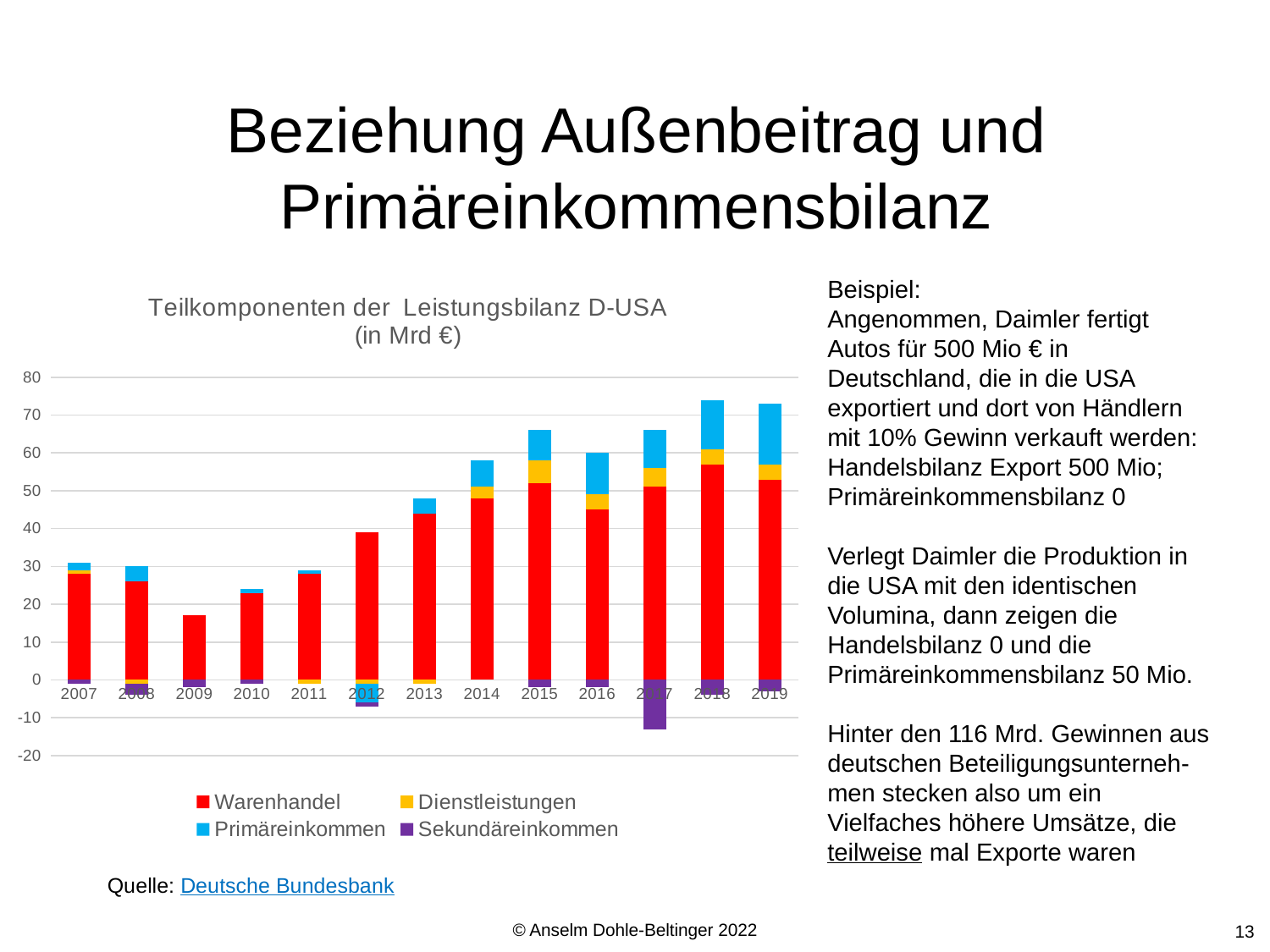
In which year is the Sekundäreinkommen (purple) segment the most negative? 2017 What is the title of the chart? Teilkomponenten der Leistungsbilanz D-USA (in Mrd €) Does the Warenhandel value generally rise or fall from 2009 to 2018? rise How many years are shown on the x axis? 13 How many series does the legend list? 4 In which year is the Warenhandel (red) segment the largest? 2018 What kind of chart is shown on the slide? stacked bar chart In which year is the Warenhandel (red) segment the smallest? 2009 Is the Warenhandel value for 2009 greater or less than 20? less Which series is shown in red? Warenhandel Is the Warenhandel value for 2018 greater or less than 50? greater Is the Warenhandel value larger in 2013 or in 2010? 2013